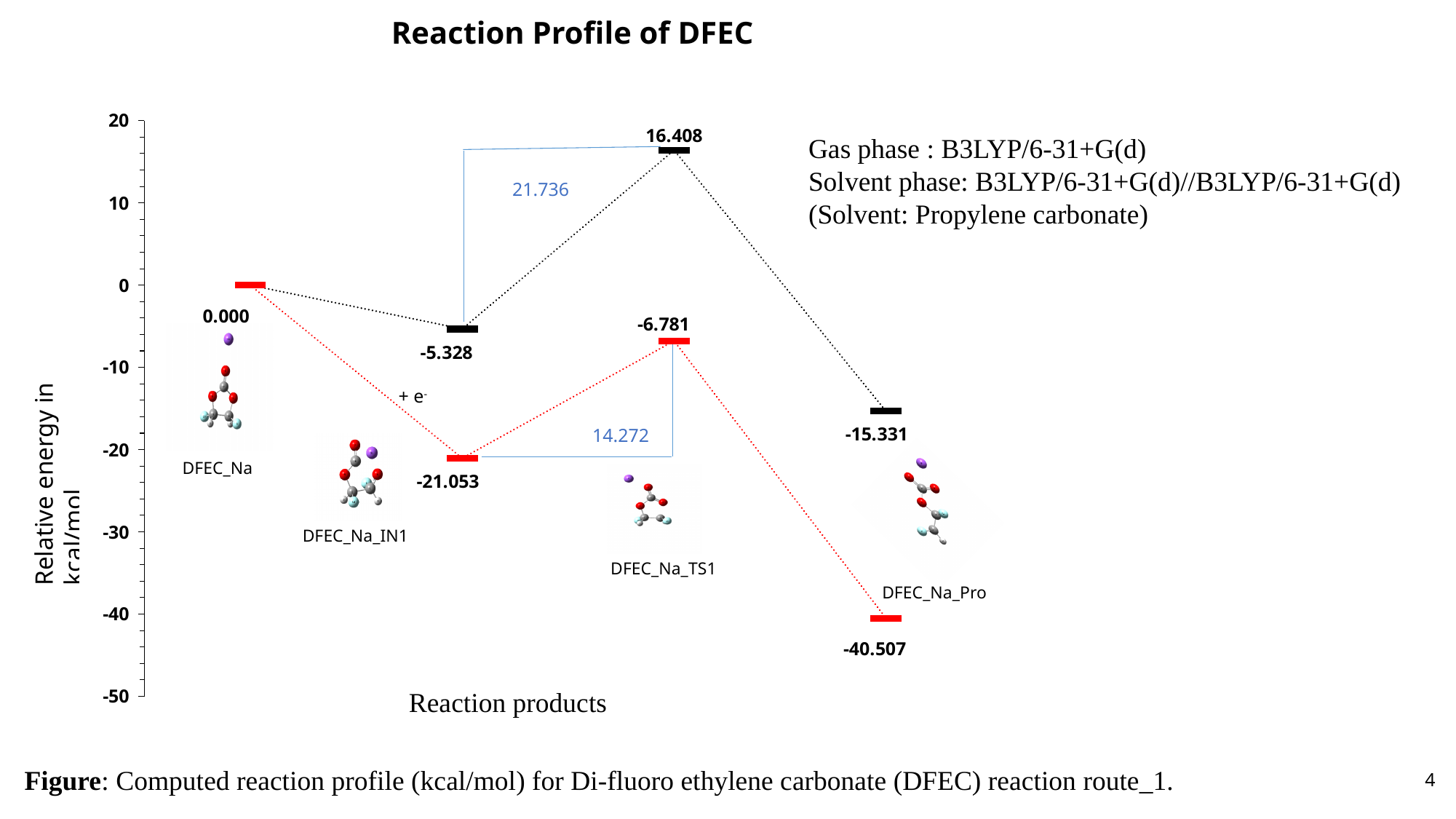
Which point on the chart has the highest relative energy? DFEC_Na_TS1 (gas phase), 16.408 What is the relative energy of the DFEC_Na_TS1 transition state on the black (gas phase) profile? 16.408 What is the activation barrier from DFEC_Na_IN1 to DFEC_Na_TS1 labelled on the red (solvent phase) profile? 14.272 What is the relative energy of DFEC_Na_IN1 on the red (solvent phase) profile? -21.053 How many labelled species (reaction stages) are shown along the x axis? 4 What is the relative energy of DFEC_Na_IN1 on the black (gas phase) profile? -5.328 What is the activation barrier from DFEC_Na_IN1 to DFEC_Na_TS1 labelled on the black (gas phase) profile? 21.736 What is the title of the chart? Reaction Profile of DFEC Which is larger, the gas phase energy of DFEC_Na_Pro (-15.331) or the solvent phase energy of DFEC_Na_Pro (-40.507)? Gas phase (-15.331) Which point on the chart has the lowest relative energy? DFEC_Na_Pro (solvent phase), -40.507 What is the relative energy of DFEC_Na_Pro on the red (solvent phase) profile? -40.507 What is the relative energy of the DFEC_Na_TS1 transition state on the red (solvent phase) profile? -6.781